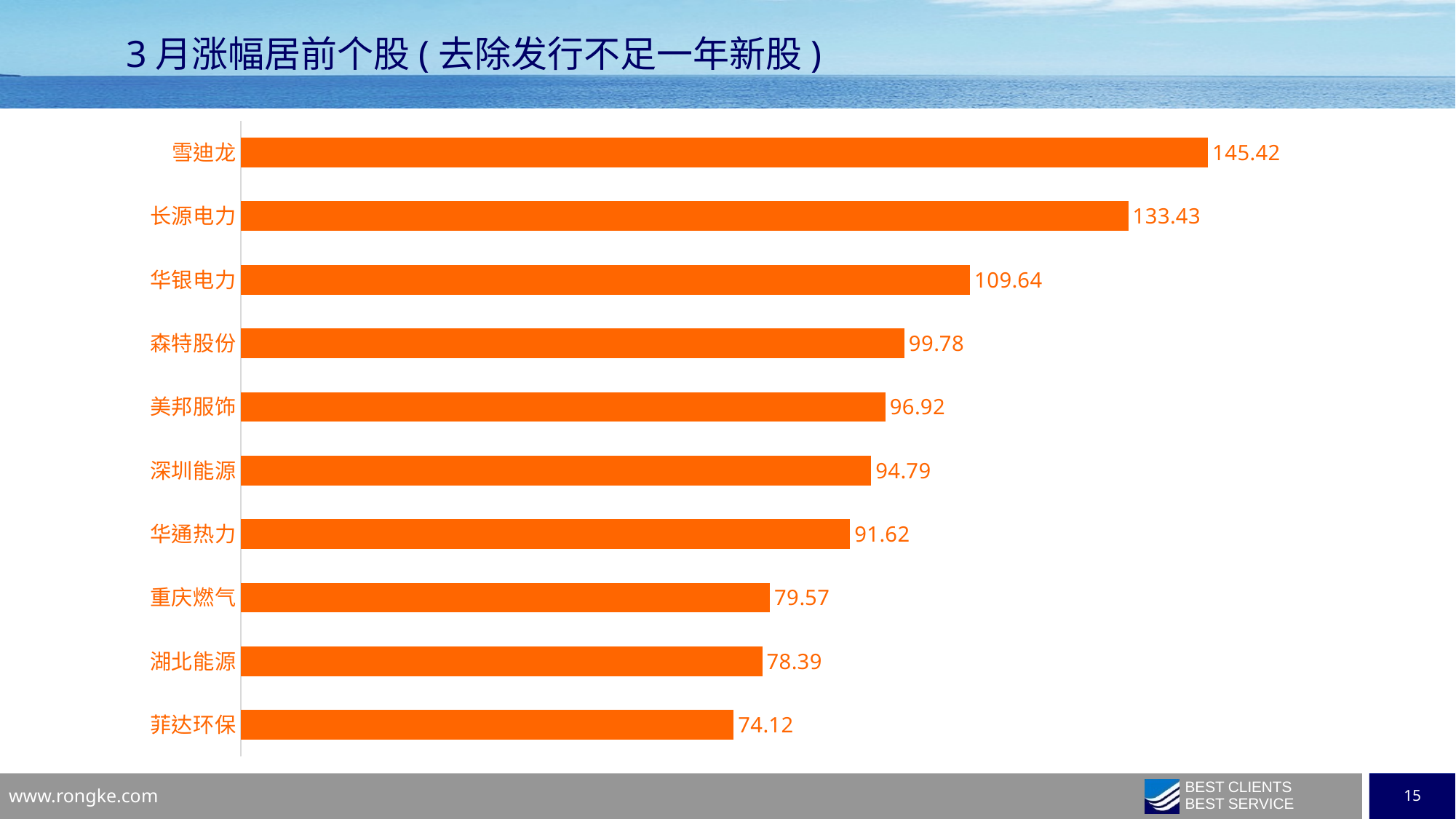
What is the title of the chart? 3月涨幅居前个股（去除发行不足一年新股） What is the difference between the values for 华银电力 and 森特股份? 9.86 What is the value for 菲达环保? 74.12 How many stocks are shown in the chart? 10 What is the value for 深圳能源? 94.79 What is the value for 雪迪龙? 145.42 What is the difference between the values for 雪迪龙 and 长源电力? 11.99 Which is larger, the value for 华通热力 or the value for 重庆燃气? 华通热力 Which stock has the lowest value? 菲达环保 What colour are the bars in the chart? Orange What kind of chart is shown on the slide? Bar chart Which stock has the highest value? 雪迪龙